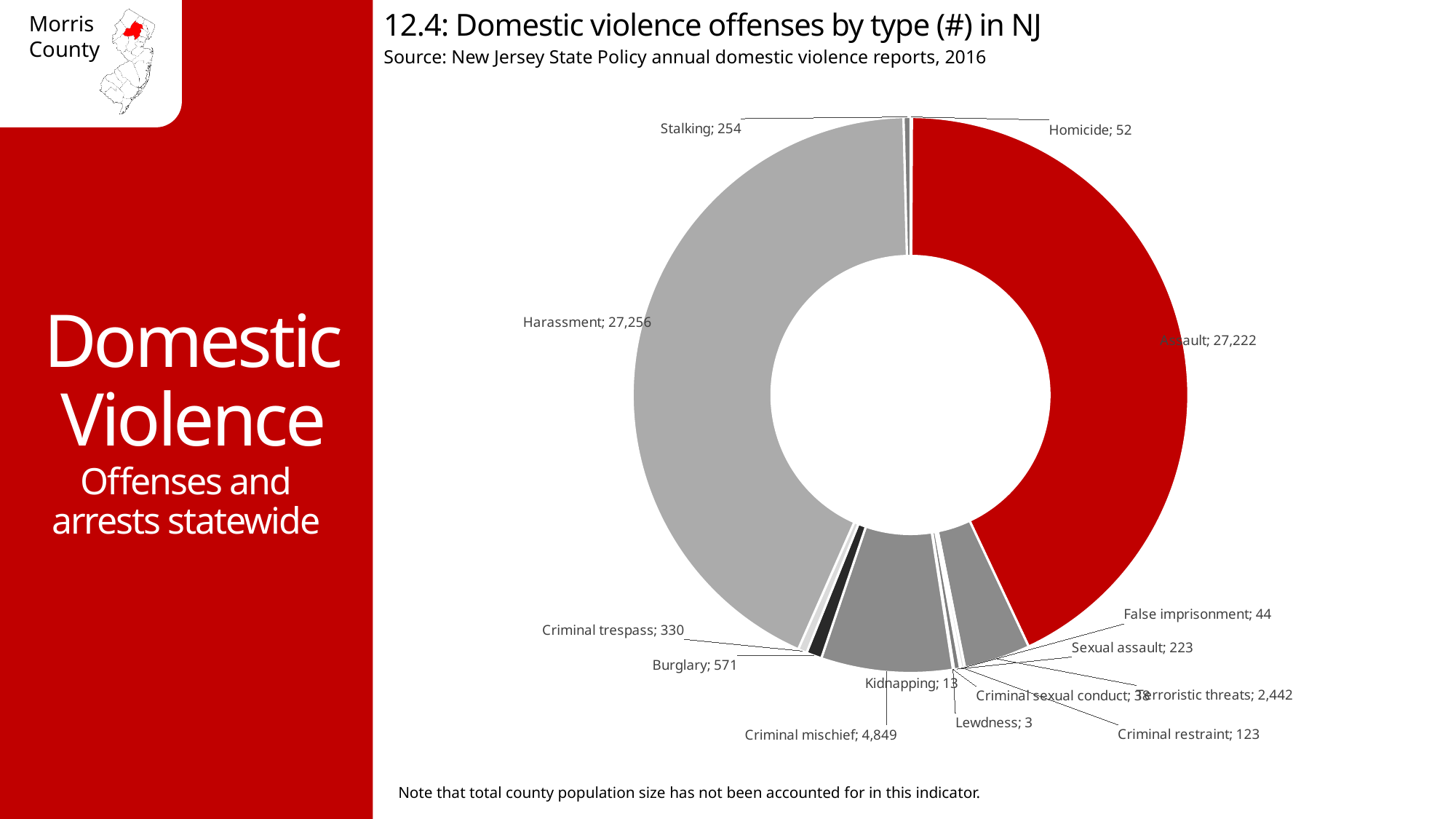
How many offense types are shown in the chart? 14 What is the value for Burglary? 571 What is the value for Criminal mischief? 4,849 What kind of chart is shown on the slide? doughnut chart What is the number of Harassment offenses shown in the chart? 27,256 What is the difference between Criminal mischief and Terroristic threats? 2,407 How many Terroristic threats offenses are shown? 2,442 Which is larger, Harassment or Assault? Harassment What is the value for Assault in the chart? 27,222 What is the title of the chart? 12.4: Domestic violence offenses by type (#) in NJ What is the difference between Burglary and Criminal trespass? 241 Which offense type has the lowest value in the chart? Lewdness